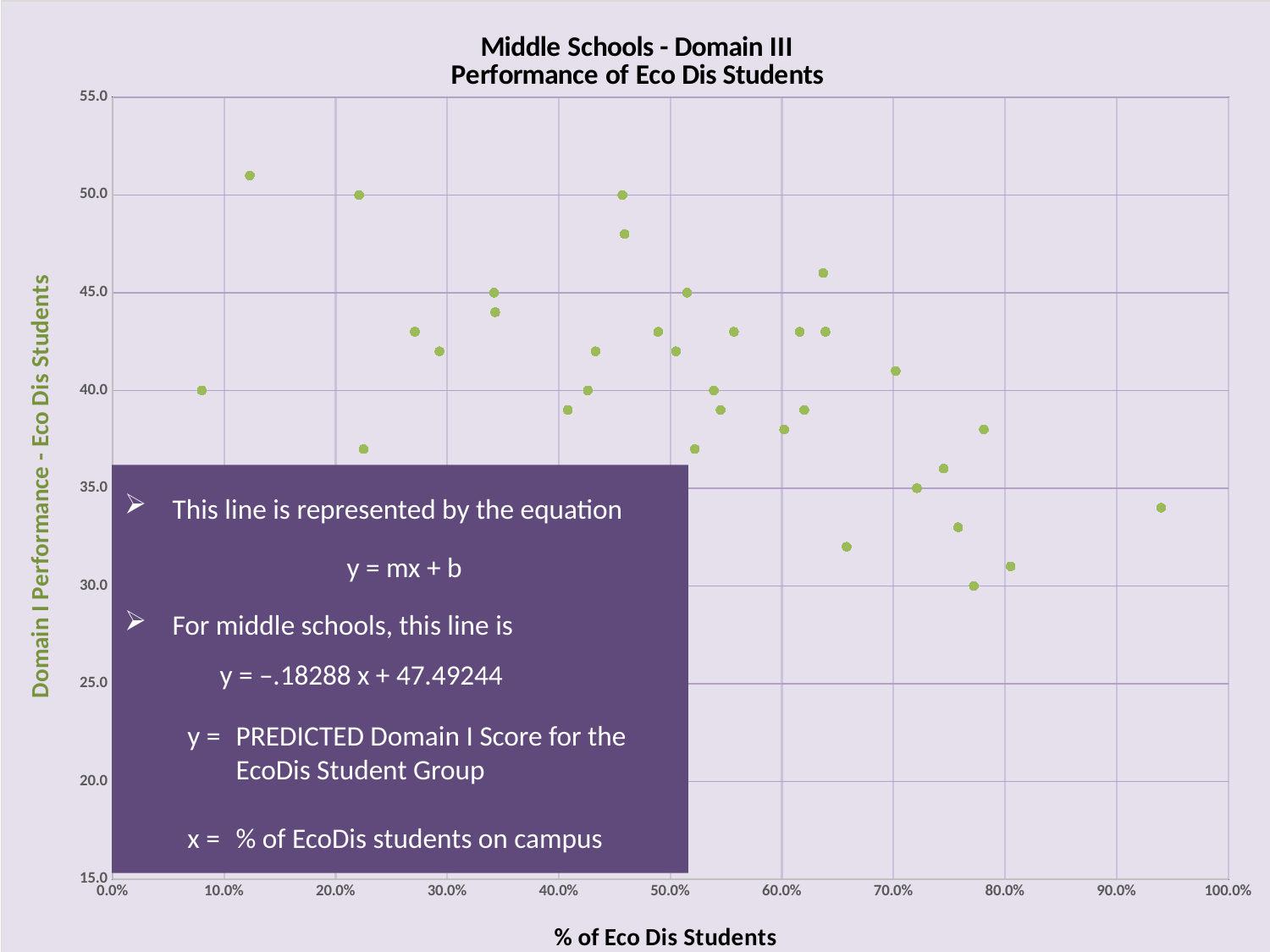
Is the lowest plotted point on the chart greater or less than 35.0? less Which is higher on the y axis: the point near 12% on the x axis or the point near 94% on the x axis? the point near 12% Is the plotted point nearest 94% on the x axis greater or less than 40.0? less What kind of chart is shown on the slide? scatter chart Is the highest plotted point on the chart greater or less than 50.0? greater What is the title of the chart? Middle Schools - Domain III Performance of Eco Dis Students What is the label of the x axis of the chart? % of Eco Dis Students Which is higher on the y axis: the point near 77% on the x axis or the point near 70% on the x axis? the point near 70% Overall, do the plotted Domain I Performance values tend to rise or fall as the % of Eco Dis Students increases? fall